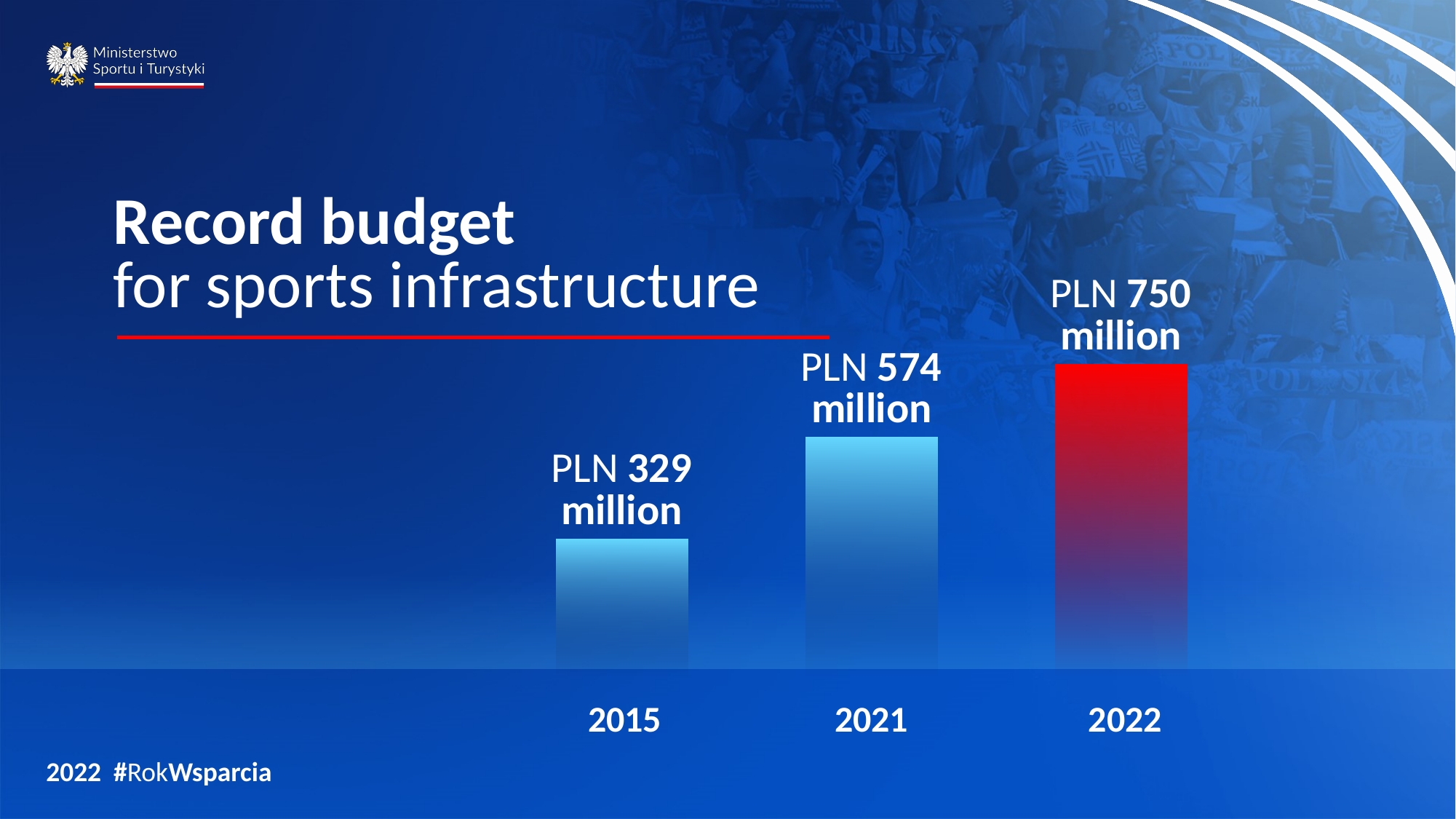
What colour is the bar for 2022? Red By how much does the 2021 budget exceed the 2015 budget? PLN 245 million Which year has the highest budget on the chart? 2022 By how much does the 2022 budget exceed the 2021 budget? PLN 176 million What kind of chart is shown on the slide? Bar chart Which is larger, the budget for 2015 or the budget for 2021? 2021 Do the budget values rise or fall from 2015 to 2022? Rise Which year has the lowest budget on the chart? 2015 What is the budget for sports infrastructure shown for 2015? PLN 329 million What is the budget for sports infrastructure shown for 2021? PLN 574 million How many years are shown on the chart? 3 What is the budget for sports infrastructure shown for 2022? PLN 750 million